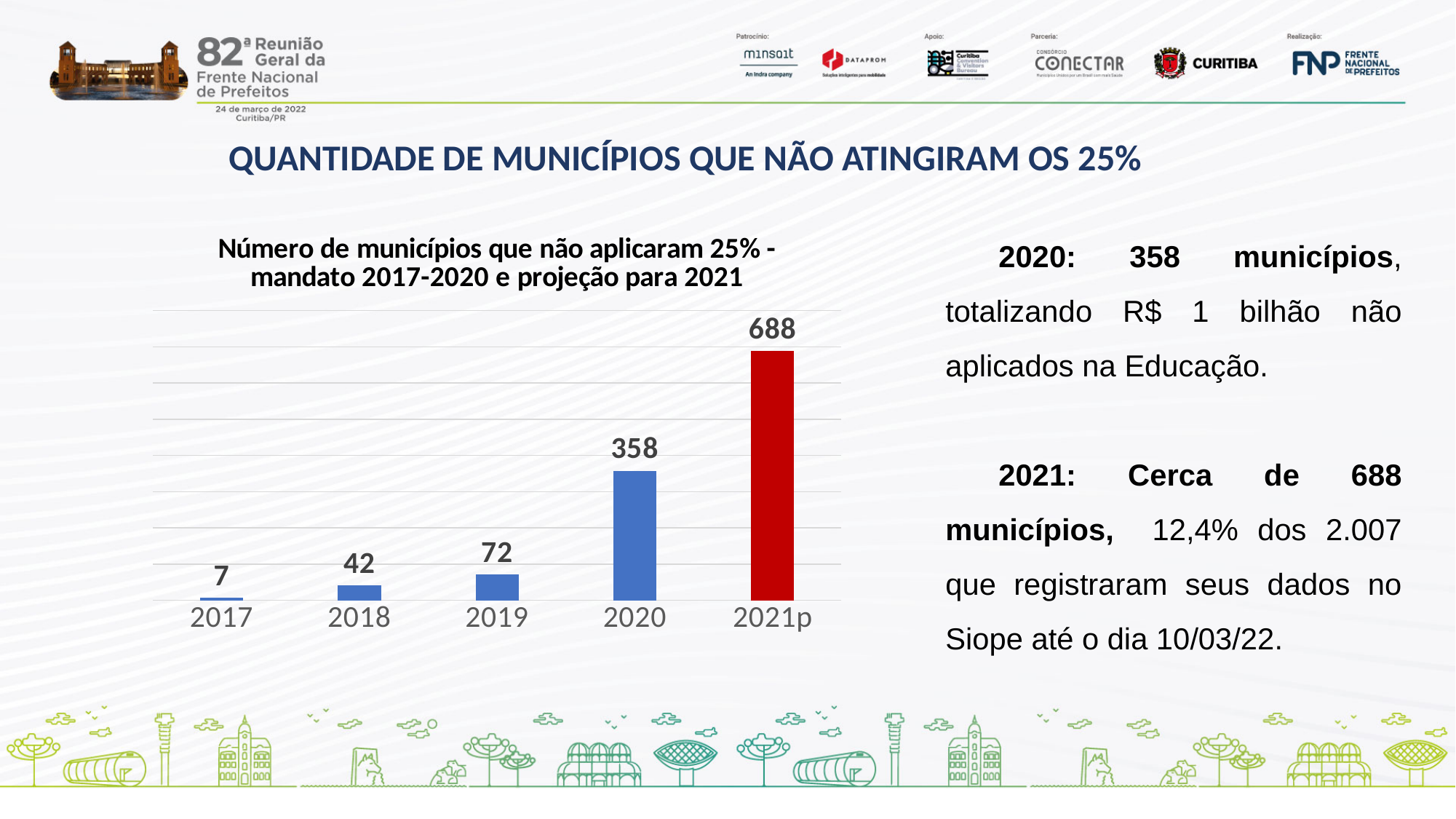
Which year has the lowest value in the chart? 2017 What is the difference between the values for 2021p and 2020? 330 What is the value for 2020 in the chart? 358 How many years (categories) are shown in the chart? 5 What is the value for 2019 in the chart? 72 What is the difference between the values for 2019 and 2018? 30 Do the values rise or fall from 2017 to 2021p? Rise Which year has the highest value in the chart? 2021p What is the value for 2017 in the chart? 7 What kind of chart is shown on the slide? Bar chart Which is larger, the value for 2018 or the value for 2019? 2019 What is the value for 2021p in the chart? 688